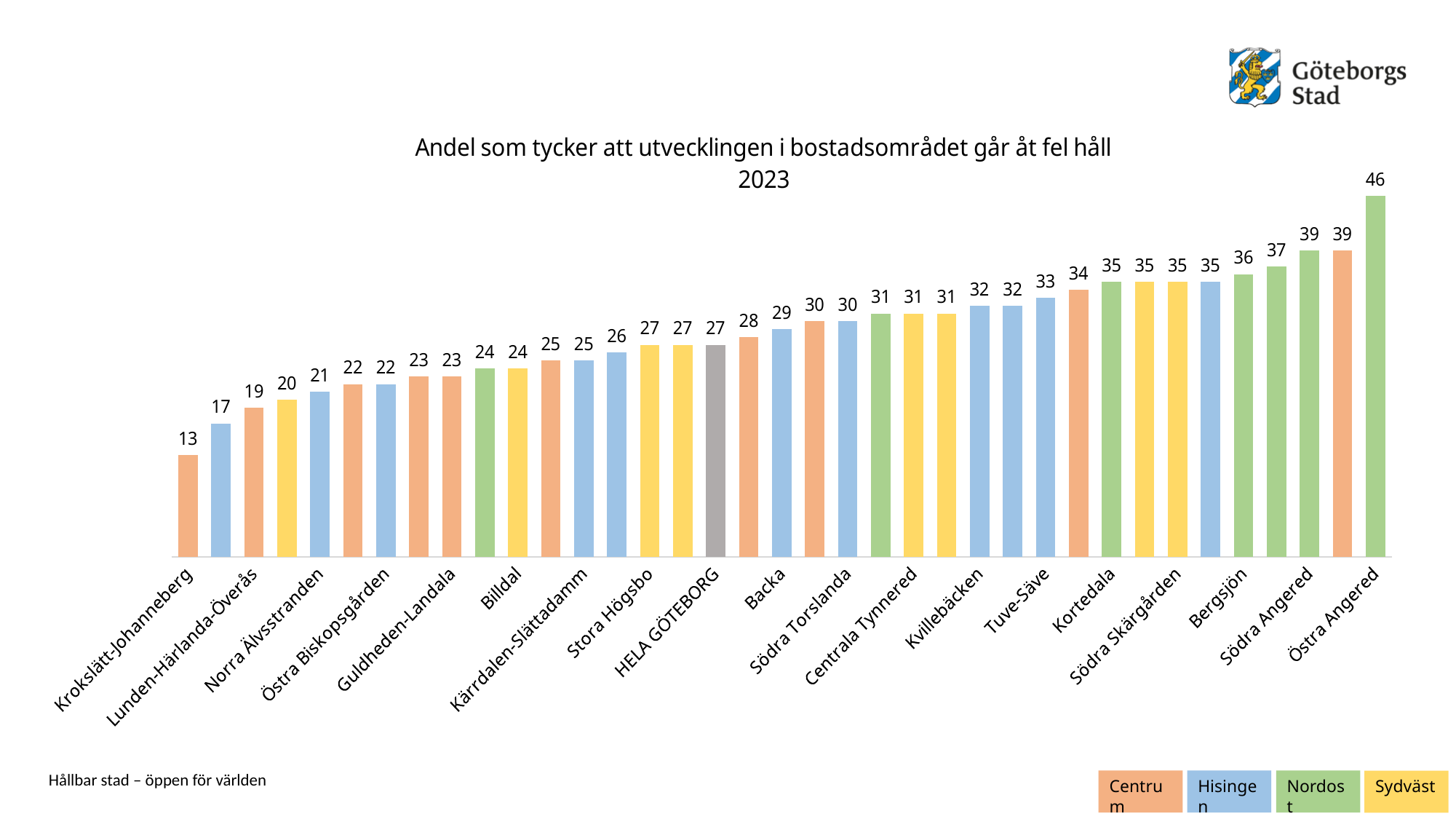
What is the value for HELA GÖTEBORG? 27 Do the values rise or fall from left to right along the x axis? Rise Which has a larger value, Bergsjön or Backa? Bergsjön What kind of chart is shown on the slide? Bar chart What is the value for Östra Angered? 46 How many bars are plotted in the chart? 37 What is the value for Billdal? 24 Which area has the lowest value? Krokslätt-Johanneberg Which area has the highest value? Östra Angered What is the value for Kortedala? 35 How many entries does the legend list? 4 What is the difference between the values for Östra Angered and Krokslätt-Johanneberg? 33